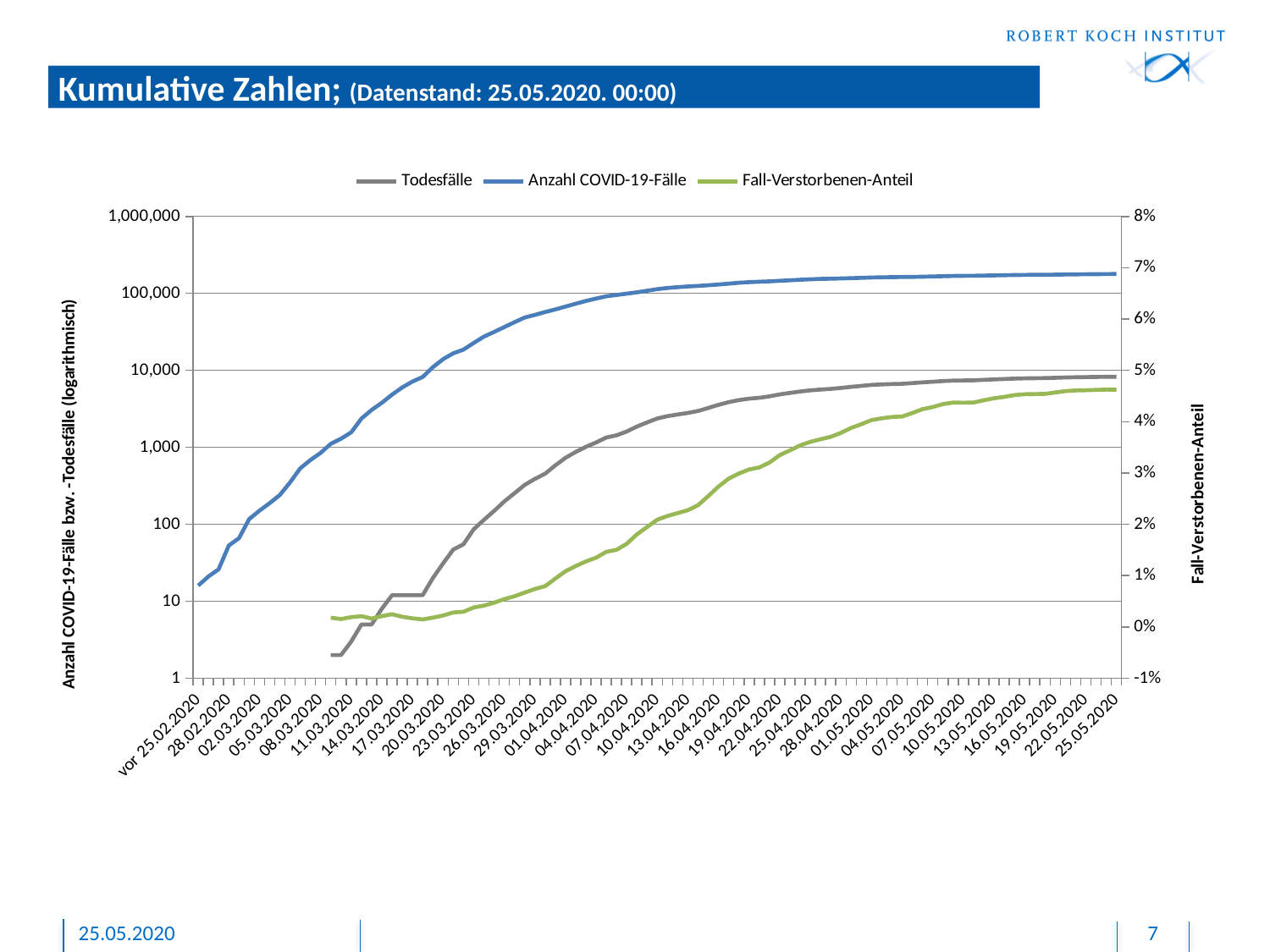
Is the value of Todesfälle on 25.05.2020 greater or less than 10,000? less How many series does the legend list? 3 Is the Fall-Verstorbenen-Anteil on 25.05.2020 greater or less than 4%? greater What is the label of the right-hand vertical axis? Fall-Verstorbenen-Anteil Is the value of Anzahl COVID-19-Fälle at 'vor 25.02.2020' greater or less than 100? less Which series is drawn in blue? Anzahl COVID-19-Fälle On 25.05.2020, which is higher: Todesfälle or Anzahl COVID-19-Fälle? Anzahl COVID-19-Fälle What kind of chart is shown on the slide? line chart Does the Anzahl COVID-19-Fälle line rise or fall from left to right along the x axis? rise